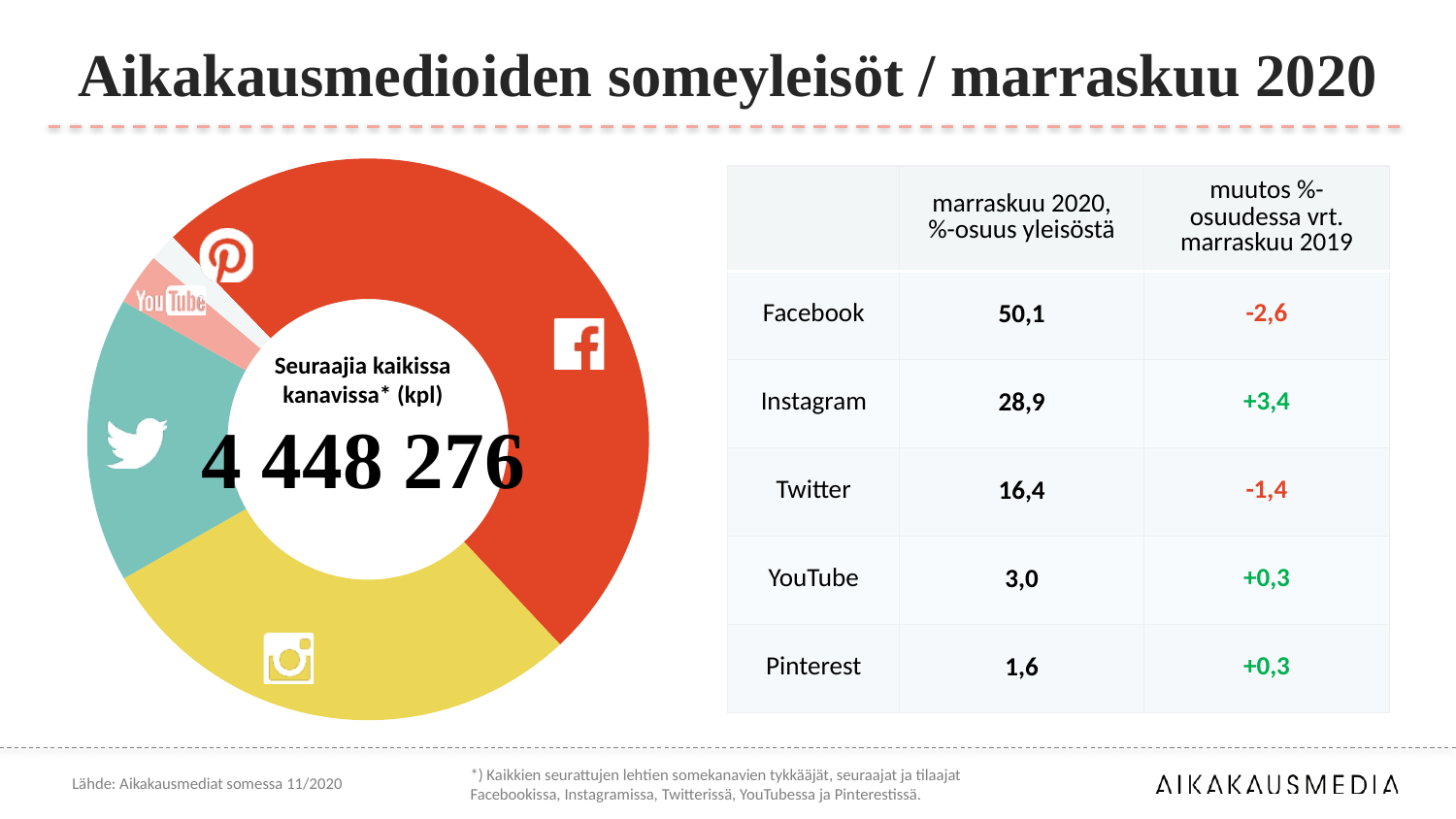
What is the difference in percentage share between Facebook and Instagram in November 2020? 21,2 Which channel has the smallest slice of the donut chart? Pinterest What kind of chart is shown on the left of the slide? Donut (pie) chart Which is larger, the share of Twitter or the share of YouTube? Twitter According to the table, what is Twitter's share of the audience in November 2020? 16,4 What is the change in Facebook's percentage share compared with November 2019? -2,6 How many channels are shown as slices in the donut chart? 5 According to the table, what is Instagram's share of the audience in November 2020? 28,9 Which channel's share changed the most compared with November 2019, according to the table? Instagram Which channel has the largest slice of the donut chart? Facebook What total number of followers across all channels is printed in the centre of the donut chart? 4 448 276 According to the table, what is Facebook's share of the audience in November 2020? 50,1